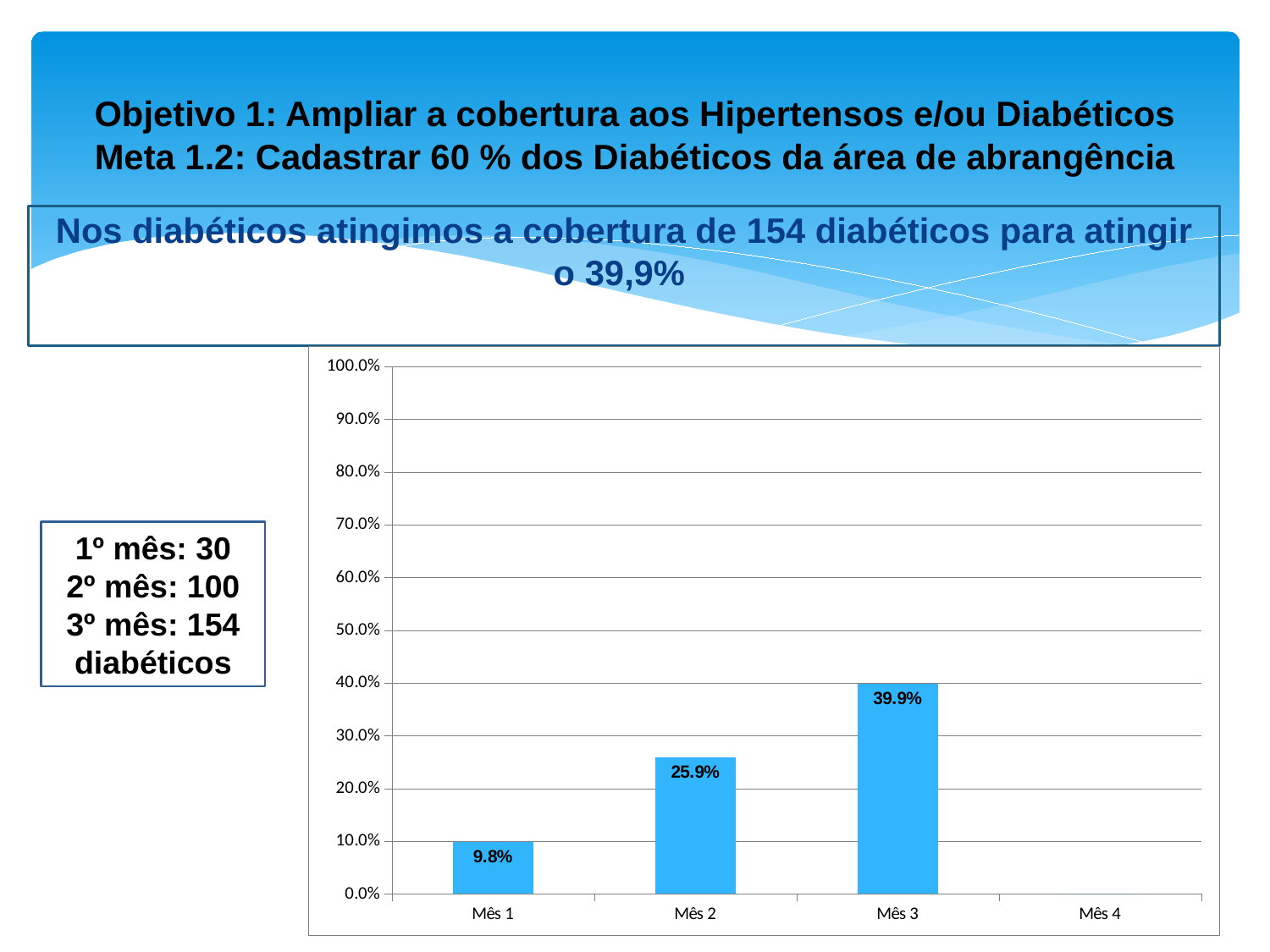
What is the value for Mês 1? 9.8% Which month with a plotted bar has the lowest value? Mês 1 What is the difference between the values for Mês 2 and Mês 1? 16.1% What is the value for Mês 2? 25.9% How many categories are shown on the x axis? 4 What kind of chart is shown on the slide? bar chart What is the value for Mês 3? 39.9% Do the values rise or fall from Mês 1 to Mês 3? rise Which is larger, the value for Mês 2 or the value for Mês 1? Mês 2 Is the value for Mês 3 greater or less than 50.0%? less What is the difference between the values for Mês 3 and Mês 2? 14.0% Which month has the highest value? Mês 3